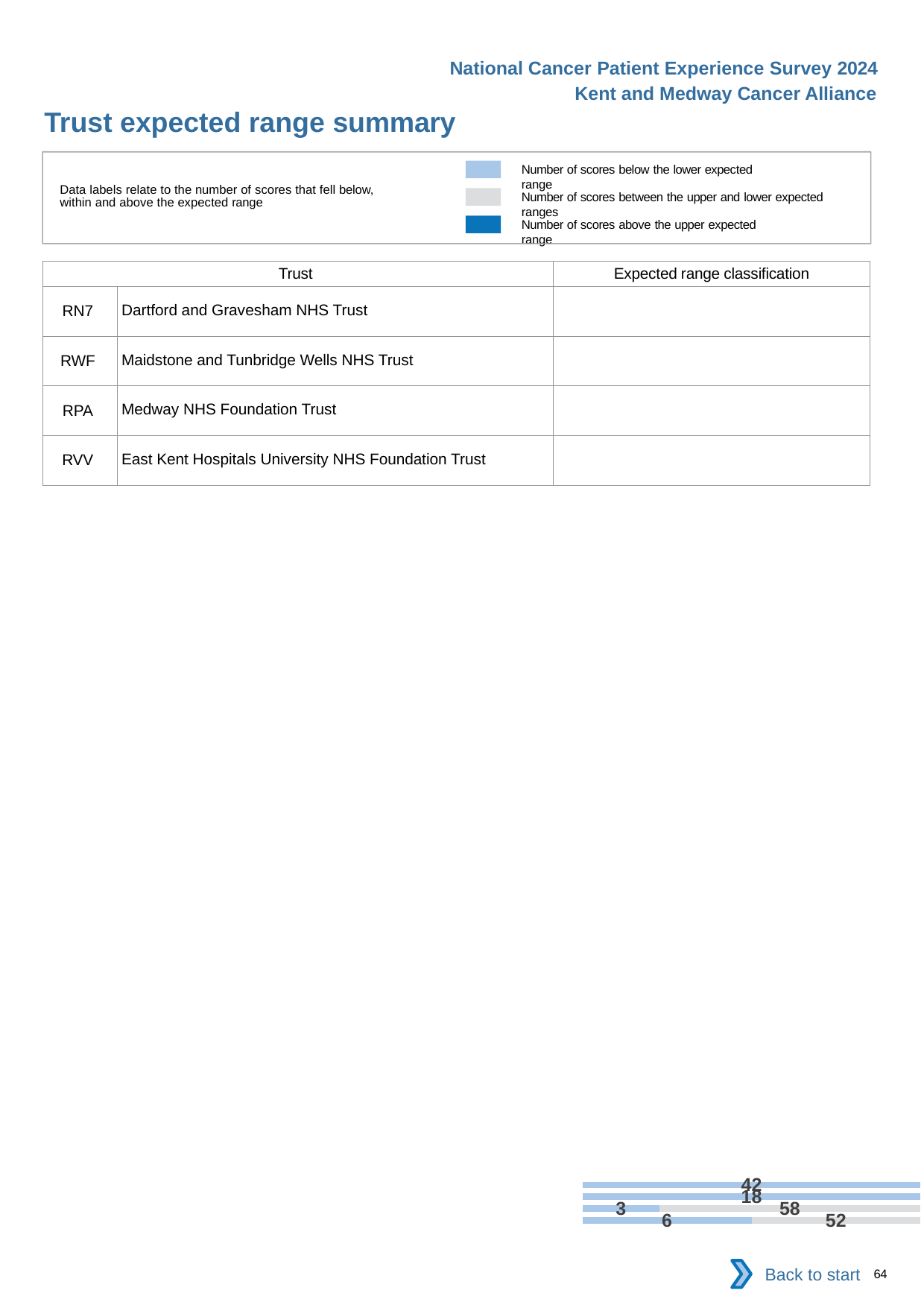
In the chart at the bottom right, what is the value printed on the light blue segment of the bottom bar? 6 In the chart at the bottom right, what is the value printed on the light blue segment of the third bar from the top? 3 In the chart at the bottom right, which is larger: the grey segment of the third bar from the top (58) or the grey segment of the bottom bar (52)? the third bar from the top (58) In the chart at the bottom right, what is the difference between the grey segment values of the third bar from the top (58) and the bottom bar (52)? 6 In the chart at the bottom right, what is the value printed on the grey segment of the bottom bar? 52 How many series does the key at the top of the slide list for the chart? 3 What kind of chart is shown at the bottom right of the slide? bar chart How many horizontal bars are plotted in the chart at the bottom right of the slide? 4 In the chart at the bottom right, what is the value printed on the grey segment of the third bar from the top? 58 In the chart at the bottom right, what is the difference between the light blue segment values of the bottom bar (6) and the third bar from the top (3)? 3 According to the key, which colour represents the number of scores below the lower expected range? light blue According to the key, which colour represents the number of scores above the upper expected range? dark blue